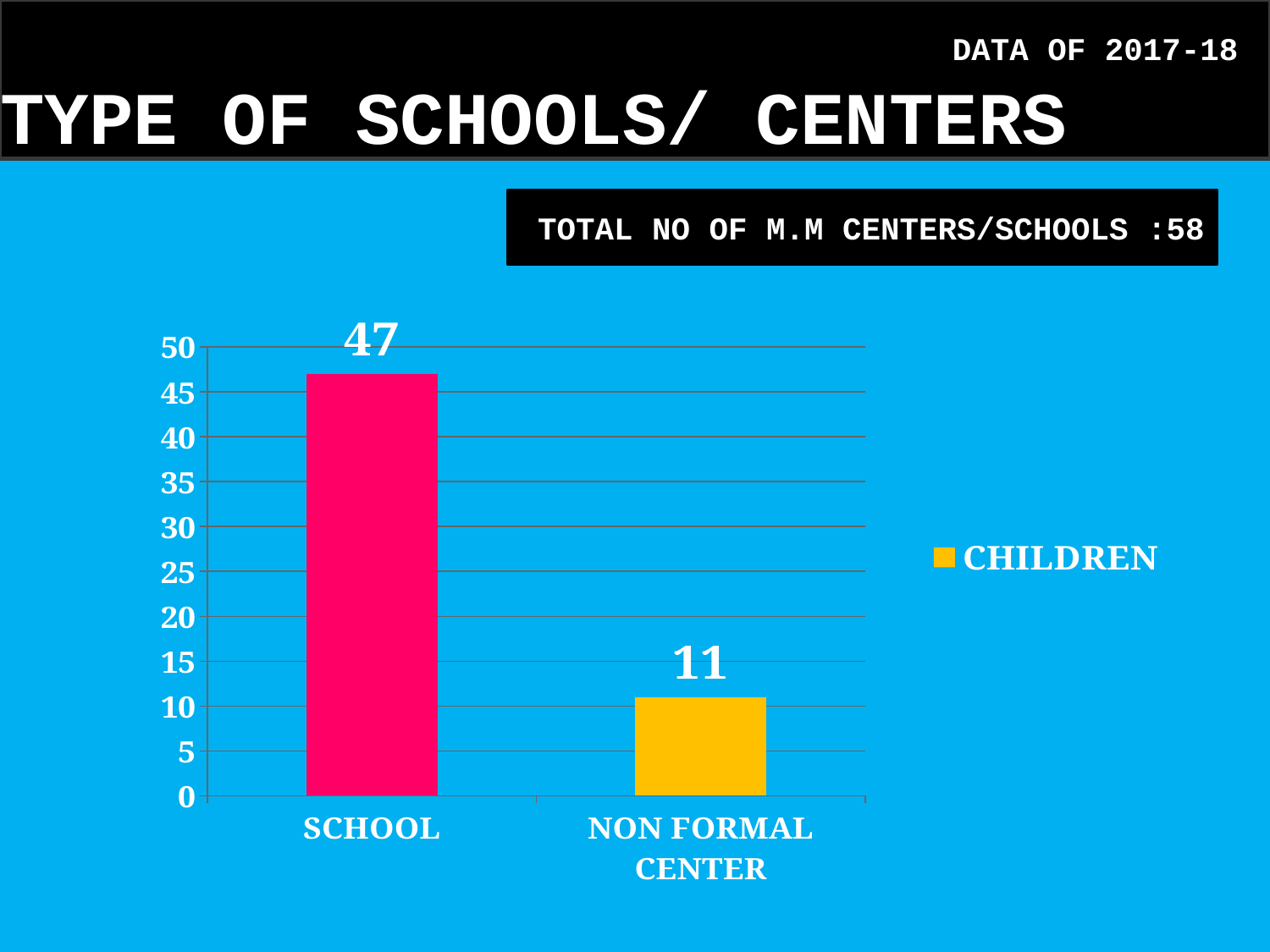
Which is larger, the value for SCHOOL or the value for NON FORMAL CENTER? SCHOOL What is the value for SCHOOL? 47 Is the value for SCHOOL greater or less than 40? greater What is the name of the series listed in the legend? CHILDREN What is the value for NON FORMAL CENTER? 11 What kind of chart is shown on the slide? bar chart Is the value for NON FORMAL CENTER greater or less than 15? less What is the difference between the values for SCHOOL and NON FORMAL CENTER? 36 Which category has the lowest value? NON FORMAL CENTER How many categories are shown on the x axis? 2 Which category has the highest value? SCHOOL How many series does the legend list? 1